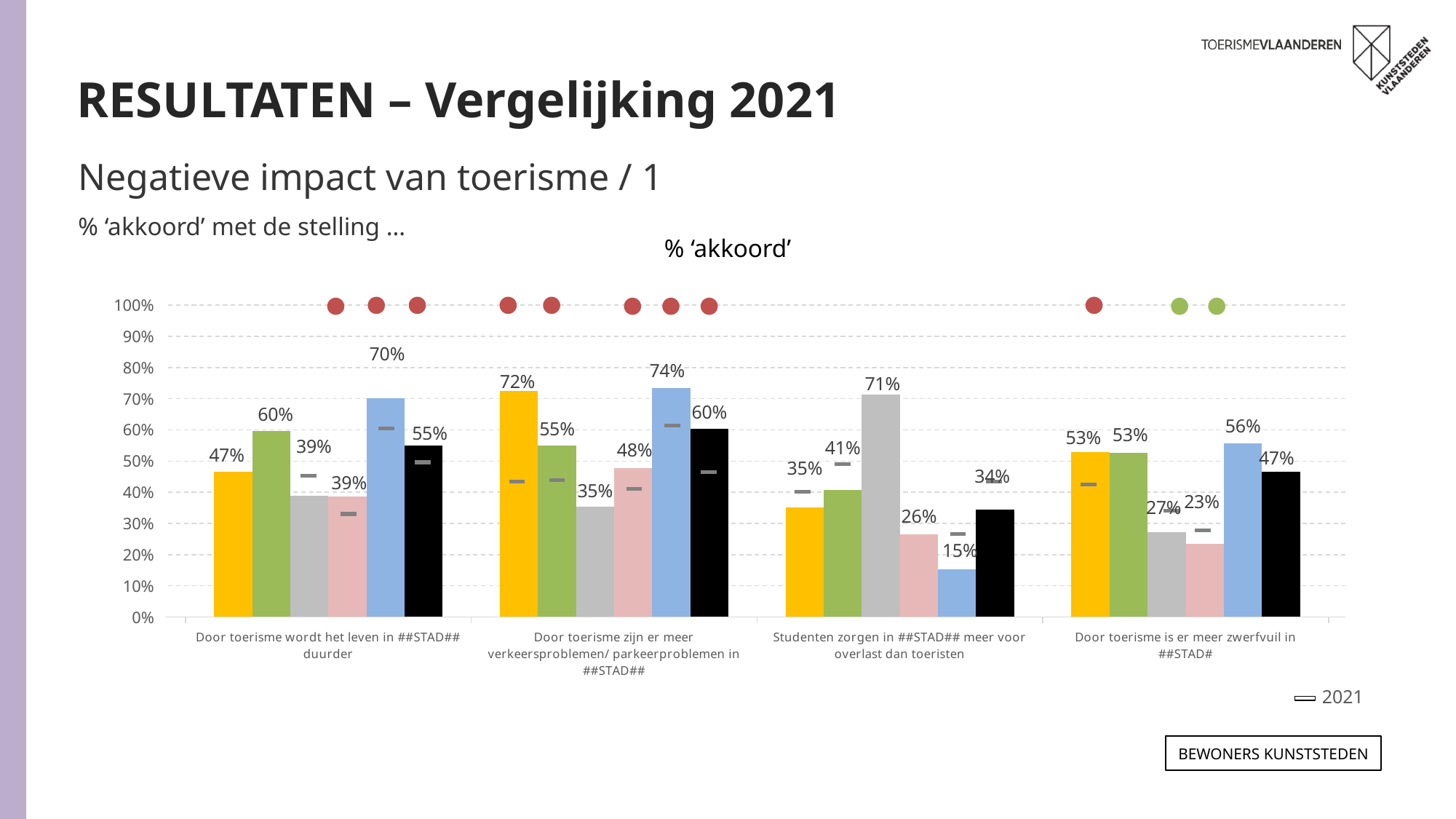
Which bar has the lowest value for the statement 'Studenten zorgen in ##STAD## meer voor overlast dan toeristen'? the blue bar (15%) What year does the dash marker in the legend represent? 2021 What is the value of the grey bar for the statement 'Studenten zorgen in ##STAD## meer voor overlast dan toeristen'? 71% What is the value of the blue bar for the statement 'Door toerisme wordt het leven in ##STAD## duurder'? 70% How many statement categories are shown along the x axis? 4 What type of chart is shown on the slide? bar chart Which bar has the highest value for the statement 'Door toerisme zijn er meer verkeersproblemen/ parkeerproblemen in ##STAD##'? the blue bar (74%) What is the difference between the blue bar (70%) and the yellow bar (47%) for the statement 'Door toerisme wordt het leven in ##STAD## duurder'? 23 percentage points What is the title of the chart? % ‘akkoord’ For the statement 'Door toerisme is er meer zwerfvuil in ##STAD#', is the grey bar or the pink bar larger? the grey bar (27%) What is the value of the yellow bar for the statement 'Door toerisme zijn er meer verkeersproblemen/ parkeerproblemen in ##STAD##'? 72% What is the value of the black bar for the statement 'Door toerisme is er meer zwerfvuil in ##STAD#'? 47%